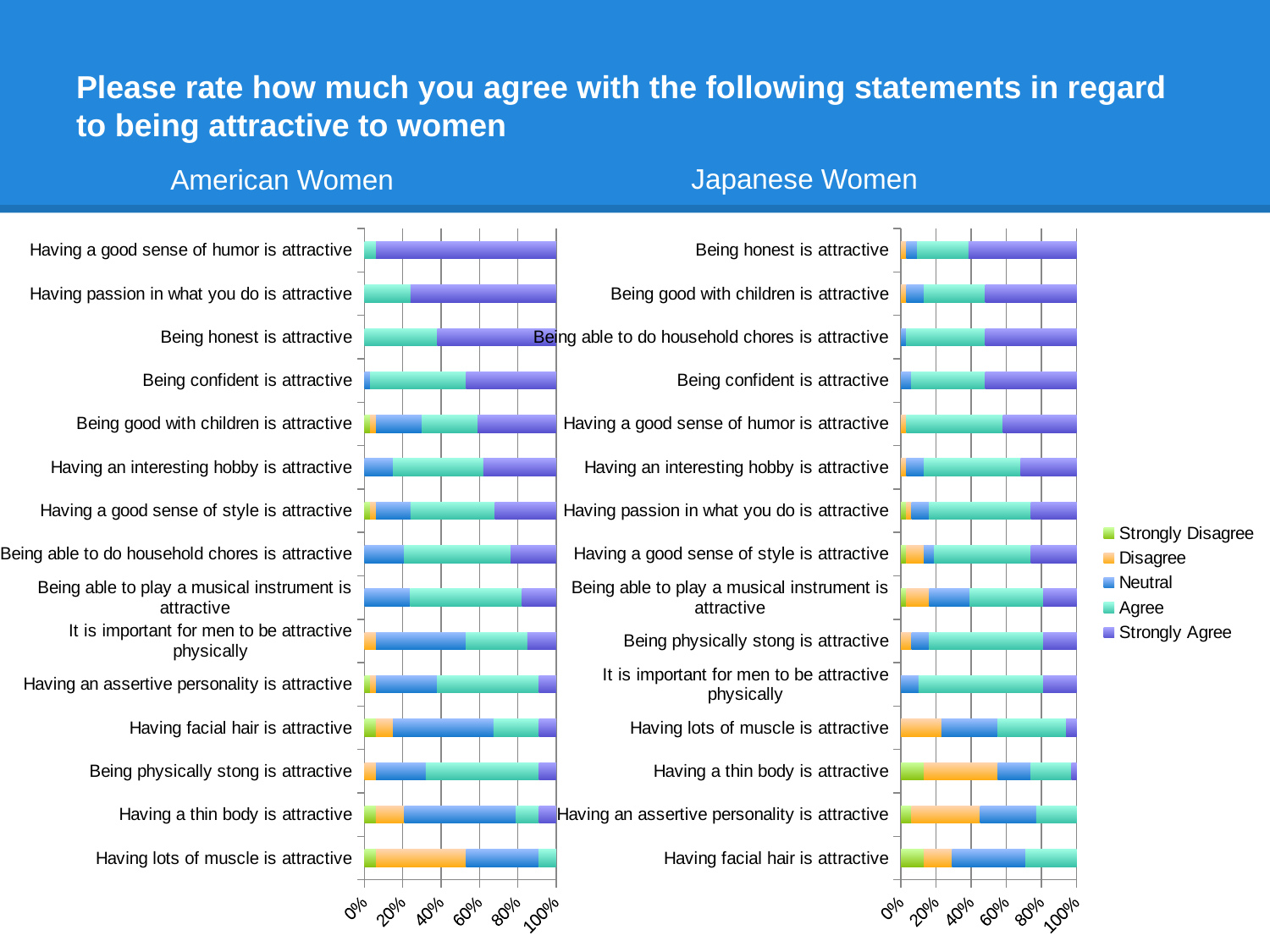
What kind of chart is the American Women chart? Stacked bar chart In the Japanese Women chart, is the Strongly Agree share for 'Having lots of muscle is attractive' greater or less than 20%? less In the American Women chart, which statement has the largest Strongly Agree share? Having a good sense of humor is attractive In the Japanese Women chart, which statement has the largest Strongly Agree share? Being honest is attractive In the Japanese Women chart, is the Strongly Agree share for 'Being honest is attractive' greater or less than 40%? greater In the American Women chart, is the Disagree share for 'Having lots of muscle is attractive' greater or less than 40%? greater How many statements are plotted in the Japanese Women chart? 15 How many series does the legend list? 5 In the American Women chart, which has the larger Strongly Agree share: 'Having passion in what you do is attractive' or 'Being honest is attractive'? Having passion in what you do is attractive How many statements are plotted in the American Women chart? 15 Which legend entry is shown in purple? Strongly Agree